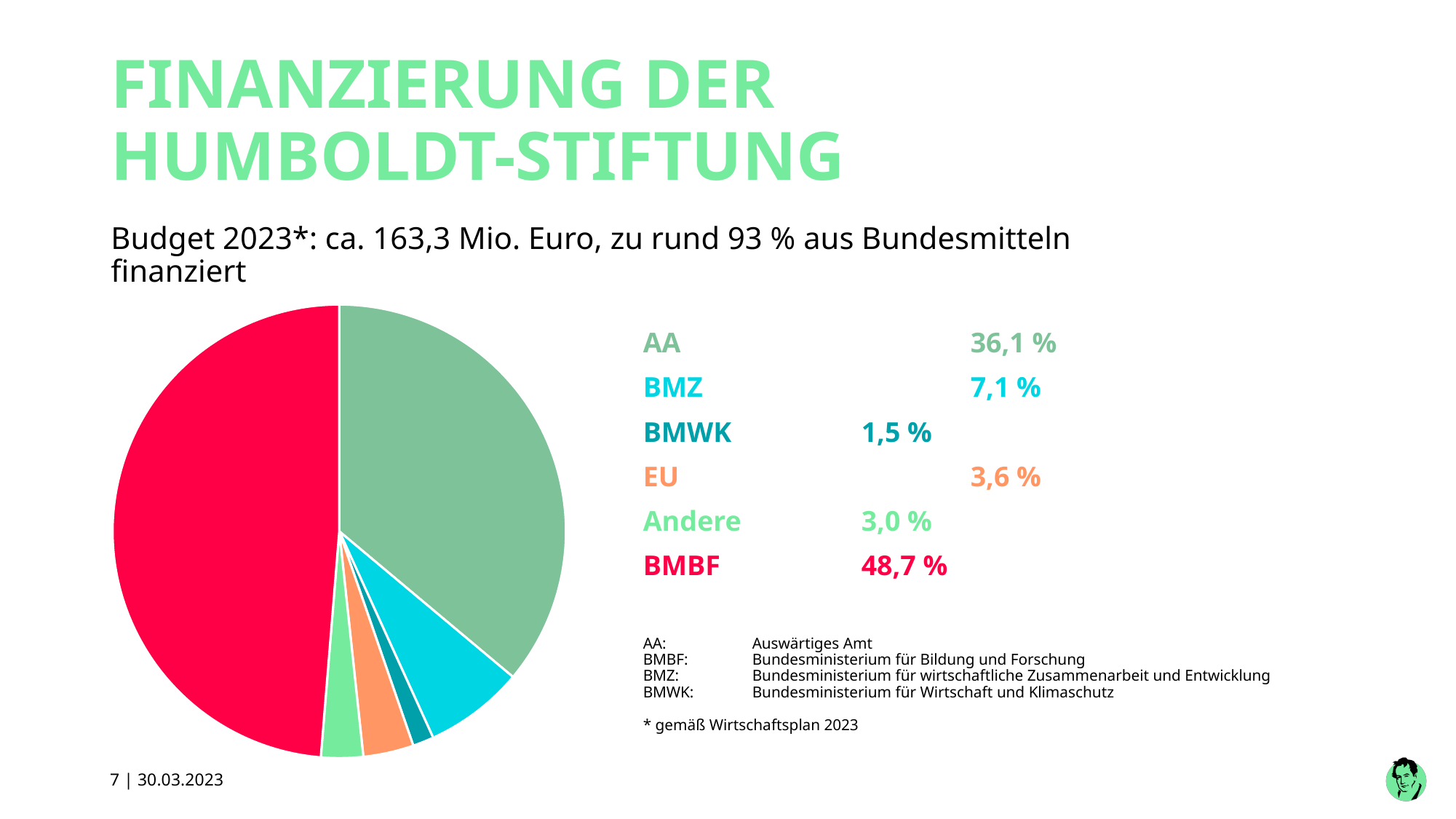
What share of the funding comes from BMWK? 1,5 % What share of the funding comes from BMZ? 7,1 % What share of the funding comes from the EU? 3,6 % What share of the funding comes from AA? 36,1 % What share of the Humboldt-Stiftung funding comes from BMBF? 48,7 % Which funding source has the smallest share of the pie? BMWK How many funding sources are shown in the pie chart? 6 Which is larger, the share for BMZ or the share for EU? BMZ Which funding source has the largest share of the pie? BMBF What kind of chart is shown on the slide? Pie chart What is the difference in percentage points between the BMBF share and the AA share? 12,6 What colour is the BMBF slice of the pie chart? Red